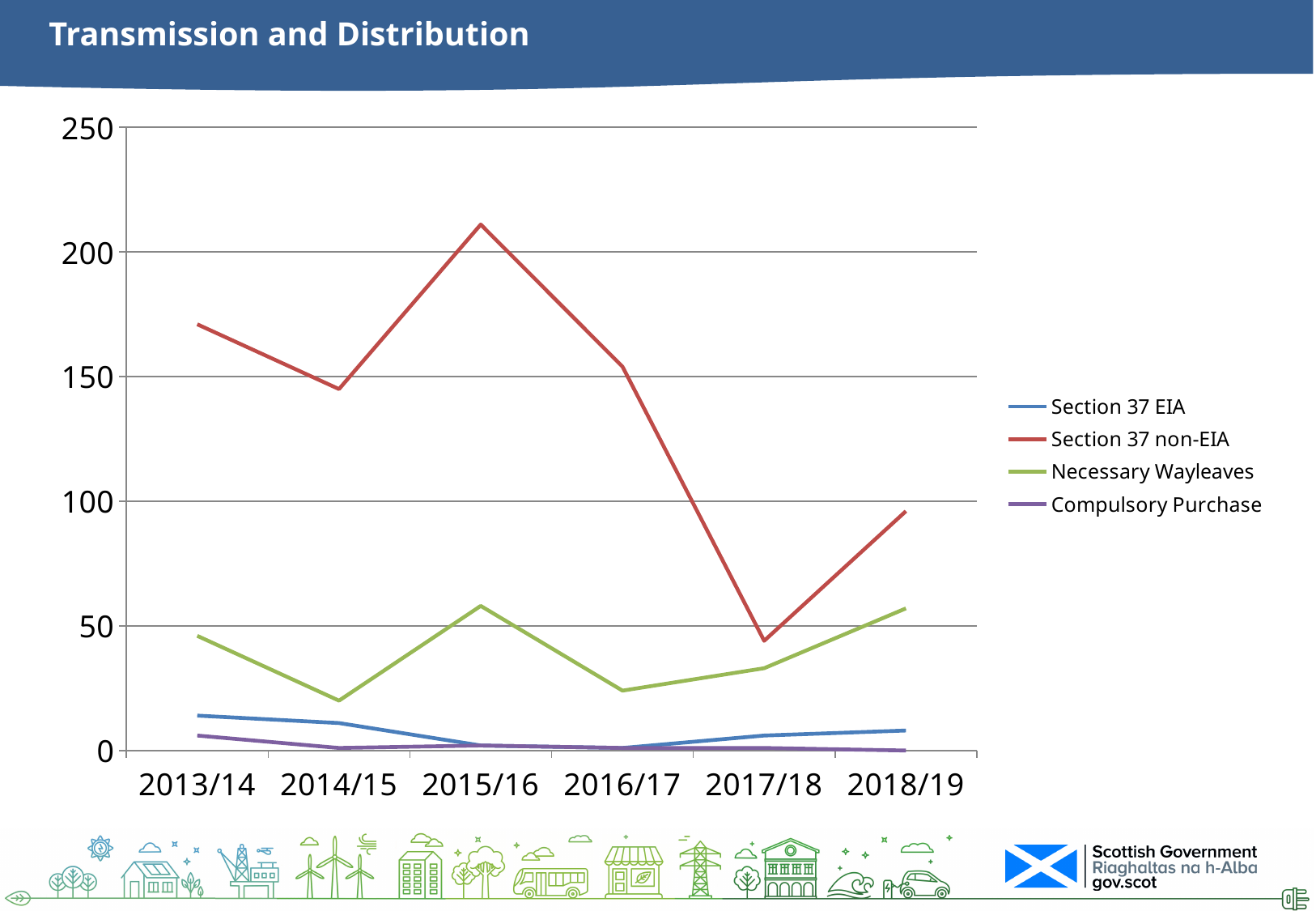
Which series is drawn in red? Section 37 non-EIA What kind of chart is shown on the slide? line chart In 2013/14, which is larger: Necessary Wayleaves or Section 37 EIA? Necessary Wayleaves Is the value for Necessary Wayleaves in 2015/16 greater or less than 50? greater How many series does the legend list? 4 In which year is the Section 37 non-EIA series at its lowest? 2017/18 Is the value for Section 37 non-EIA in 2017/18 greater or less than 50? less Is the value for Section 37 non-EIA in 2015/16 greater or less than 200? greater How many years are shown along the x axis? 6 In which year is the Section 37 non-EIA series at its highest? 2015/16 Does the Section 37 non-EIA series rise or fall between 2015/16 and 2017/18? fall